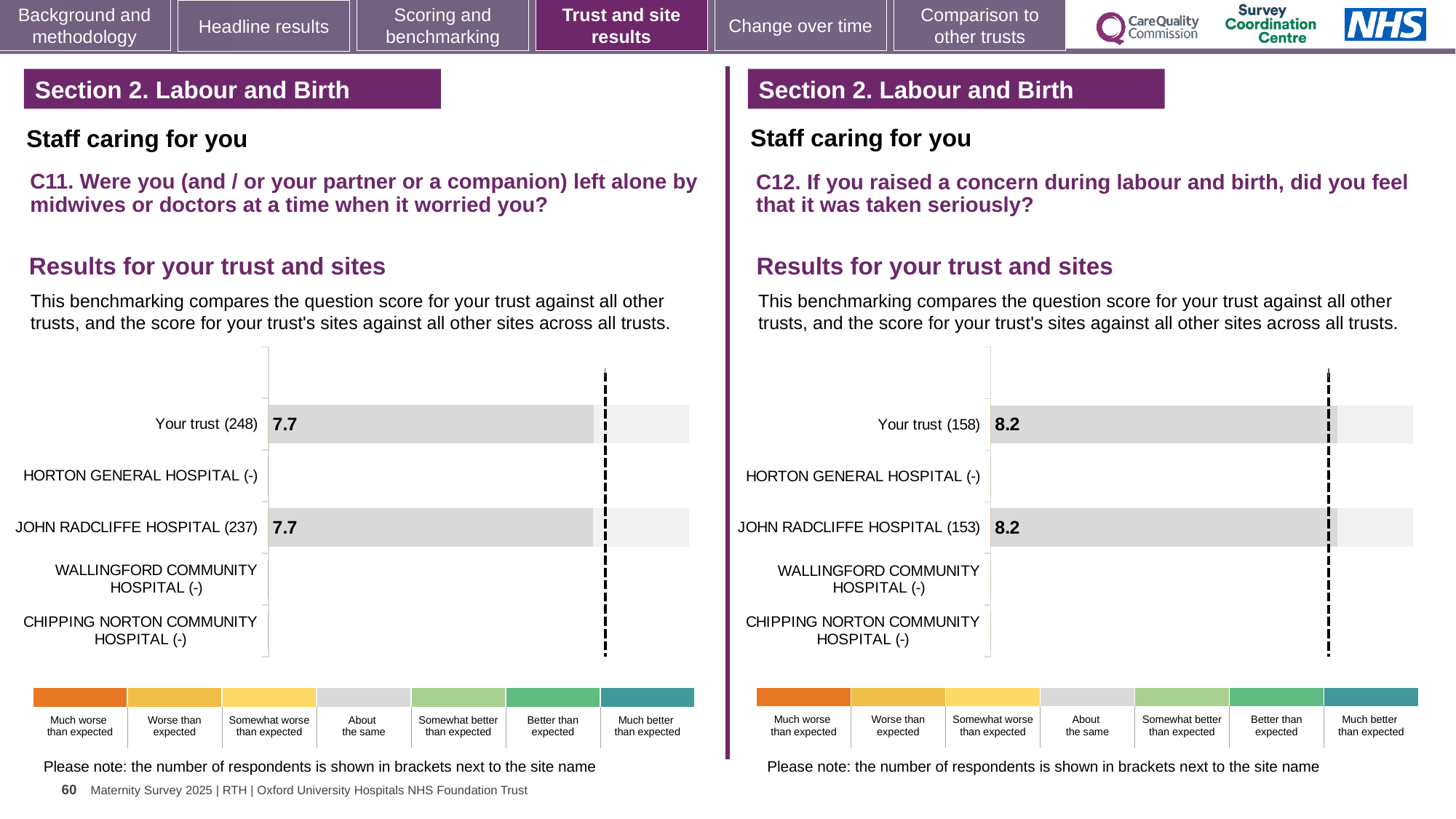
In the C12 chart on the right, what is the score for Your trust (158)? 8.2 What kind of chart is used for the C11 results on the left? Bar chart How many site or trust categories are listed on the y axis of the C12 chart on the right? 5 In the C11 chart on the left, what is the difference between the score for Your trust and the score for JOHN RADCLIFFE HOSPITAL? 0 In the C11 chart on the left, what is the score for Your trust (248)? 7.7 In the C11 chart on the left, how many respondents are shown in brackets for Your trust? 248 Is the score for Your trust in the C12 chart on the right larger or smaller than the score for Your trust in the C11 chart on the left? Larger In the C12 chart on the right, how many respondents are shown in brackets for JOHN RADCLIFFE HOSPITAL? 153 In the C12 chart on the right, what is the difference between the score for Your trust and the score for JOHN RADCLIFFE HOSPITAL? 0 How many site or trust categories are listed on the y axis of the C11 chart on the left? 5 In the C11 chart on the left, what is the score for JOHN RADCLIFFE HOSPITAL (237)? 7.7 In the C12 chart on the right, what is the score for JOHN RADCLIFFE HOSPITAL (153)? 8.2